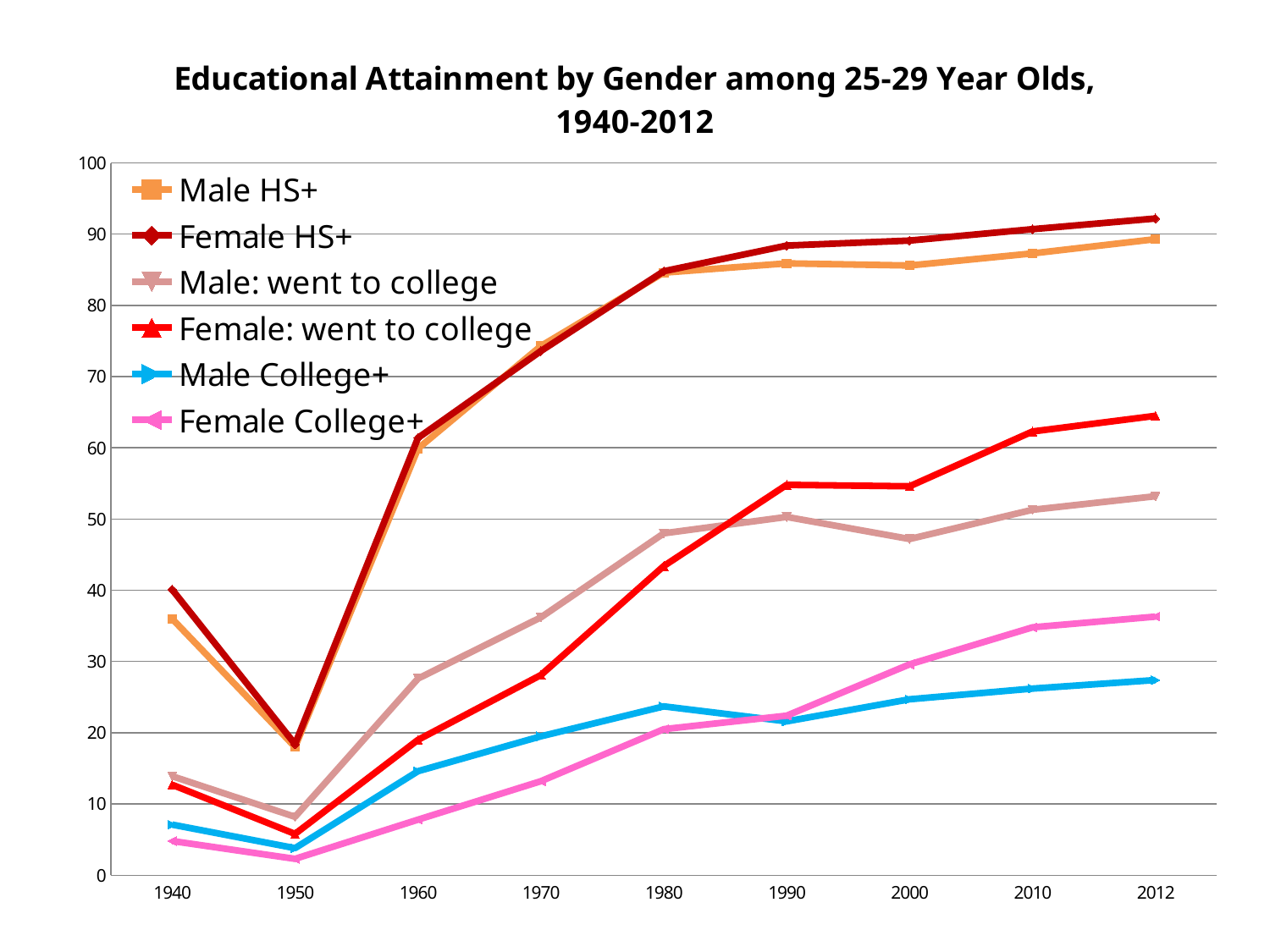
In 2012, which is higher: Male: went to college or Female: went to college? Female: went to college In which year does the Male HS+ series reach its lowest value? 1950 Is the value for Male: went to college in 2000 greater or less than 50? less Is the value for Male College+ in 1950 greater or less than 10? less Does the Female College+ series rise or fall from 1950 to 2012? rise How many years are marked along the x axis? 9 Which series has the highest value in 2012? Female HS+ Is the value for Female HS+ in 2012 greater or less than 90? greater In 1940, which is higher: Male HS+ or Female HS+? Female HS+ What kind of chart is shown on the slide? line chart How many series does the legend list? 6